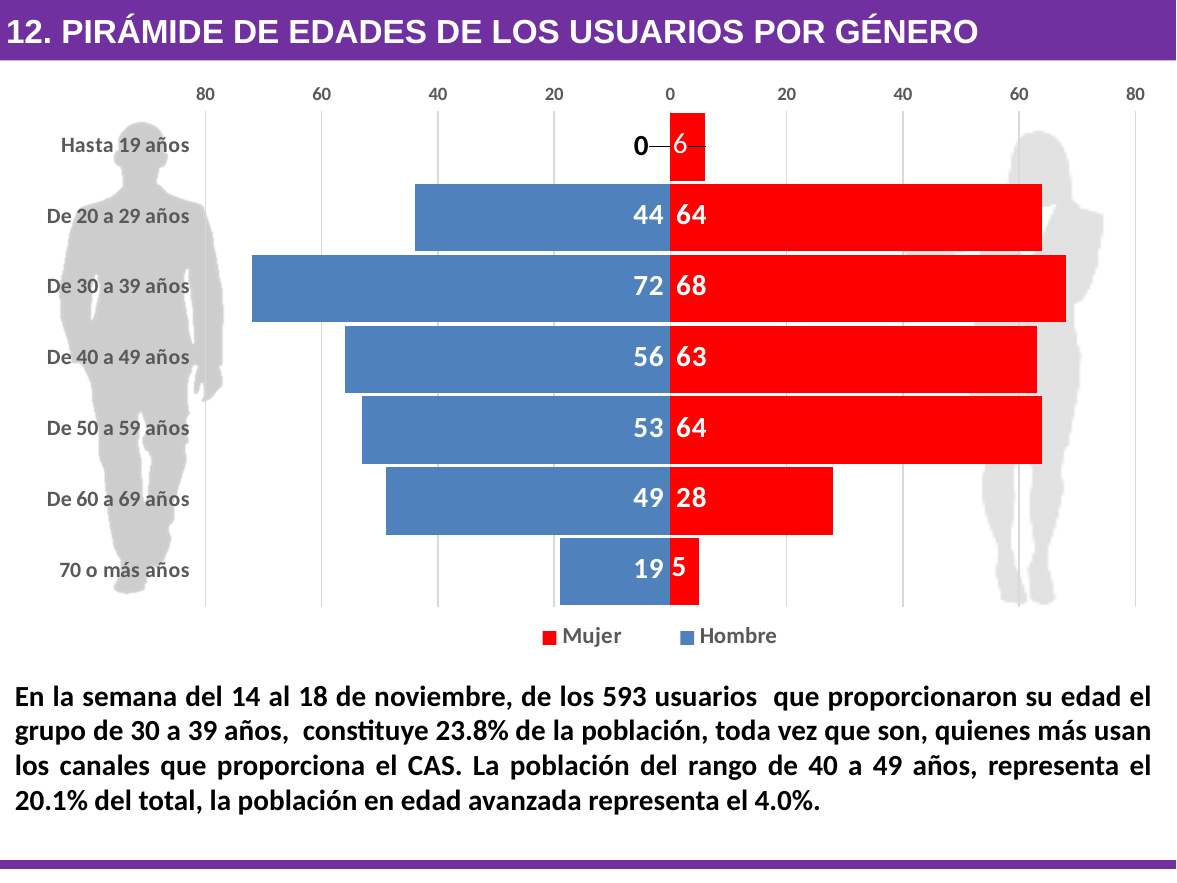
Which age group has the highest Hombre value? De 30 a 39 años What is the difference between the Mujer and Hombre values for the 'De 20 a 29 años' age group? 20 For the 'De 60 a 69 años' age group, which is larger, the Hombre value or the Mujer value? Hombre Which colour represents the Mujer series in the chart? Red Which age group has the lowest Mujer value? 70 o más años What is the Hombre value for the 'De 30 a 39 años' age group? 72 What is the total of the Hombre and Mujer values for the '70 o más años' age group? 24 What is the Mujer value for the 'De 60 a 69 años' age group? 28 How many age groups are shown in the chart? 7 How many series does the legend list? 2 What is the Hombre value for the 'Hasta 19 años' age group? 0 What kind of chart is shown on the slide? Bar chart